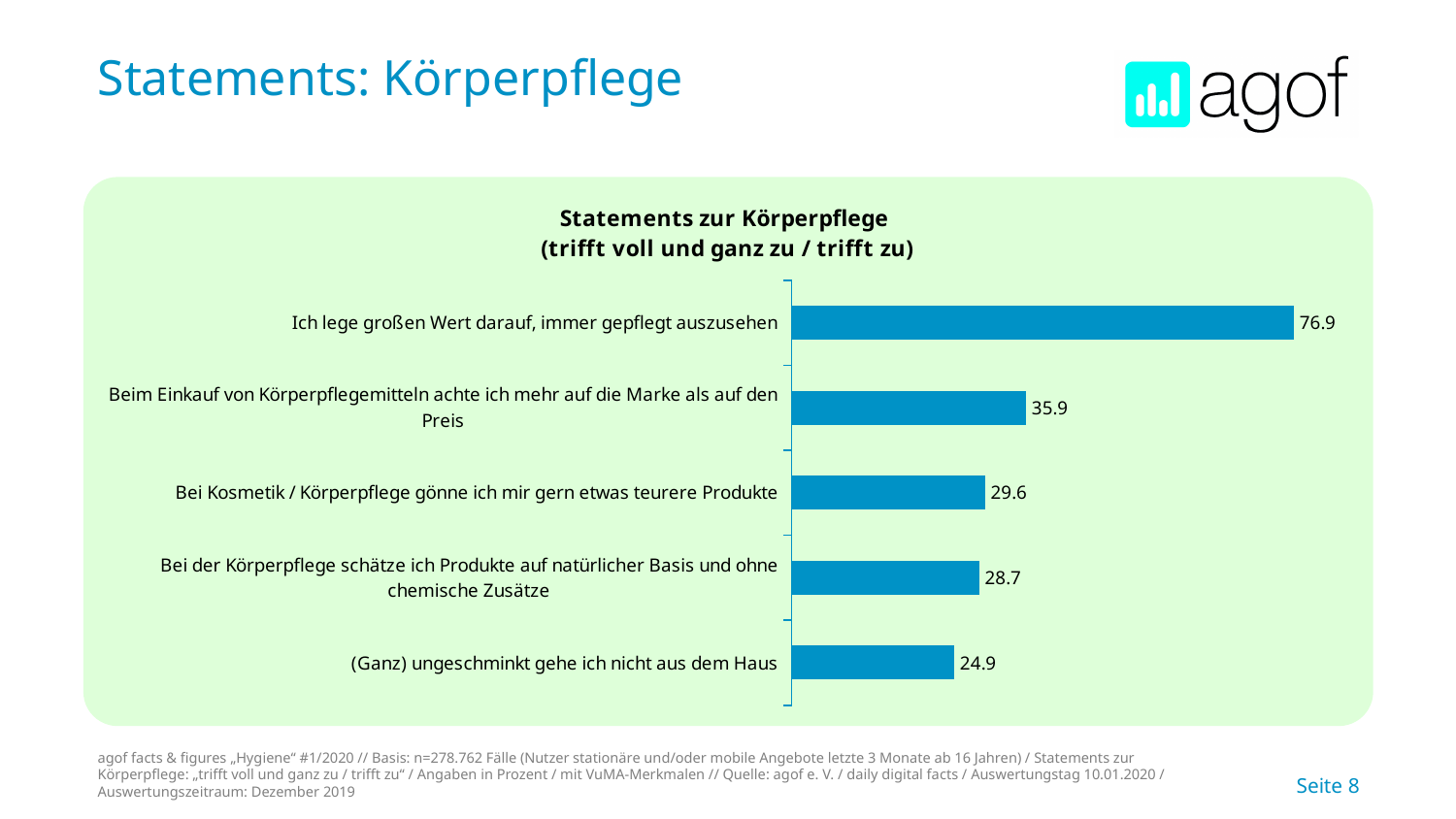
What is the value for "(Ganz) ungeschminkt gehe ich nicht aus dem Haus"? 24.9 What kind of chart is shown on the slide? Bar chart What is the difference between the values for "Bei Kosmetik / Körperpflege gönne ich mir gern etwas teurere Produkte" and "(Ganz) ungeschminkt gehe ich nicht aus dem Haus"? 4.7 Which has a larger value: "Bei Kosmetik / Körperpflege gönne ich mir gern etwas teurere Produkte" or "Bei der Körperpflege schätze ich Produkte auf natürlicher Basis und ohne chemische Zusätze"? Bei Kosmetik / Körperpflege gönne ich mir gern etwas teurere Produkte What is the difference between the values for "Ich lege großen Wert darauf, immer gepflegt auszusehen" and "Beim Einkauf von Körperpflegemitteln achte ich mehr auf die Marke als auf den Preis"? 41.0 Which statement has the lowest value? (Ganz) ungeschminkt gehe ich nicht aus dem Haus How many statements are shown in the chart? 5 What is the value for "Bei der Körperpflege schätze ich Produkte auf natürlicher Basis und ohne chemische Zusätze"? 28.7 What is the value for "Ich lege großen Wert darauf, immer gepflegt auszusehen"? 76.9 What is the value for "Beim Einkauf von Körperpflegemitteln achte ich mehr auf die Marke als auf den Preis"? 35.9 What is the title of the chart? Statements zur Körperpflege (trifft voll und ganz zu / trifft zu) Which statement has the highest value? Ich lege großen Wert darauf, immer gepflegt auszusehen